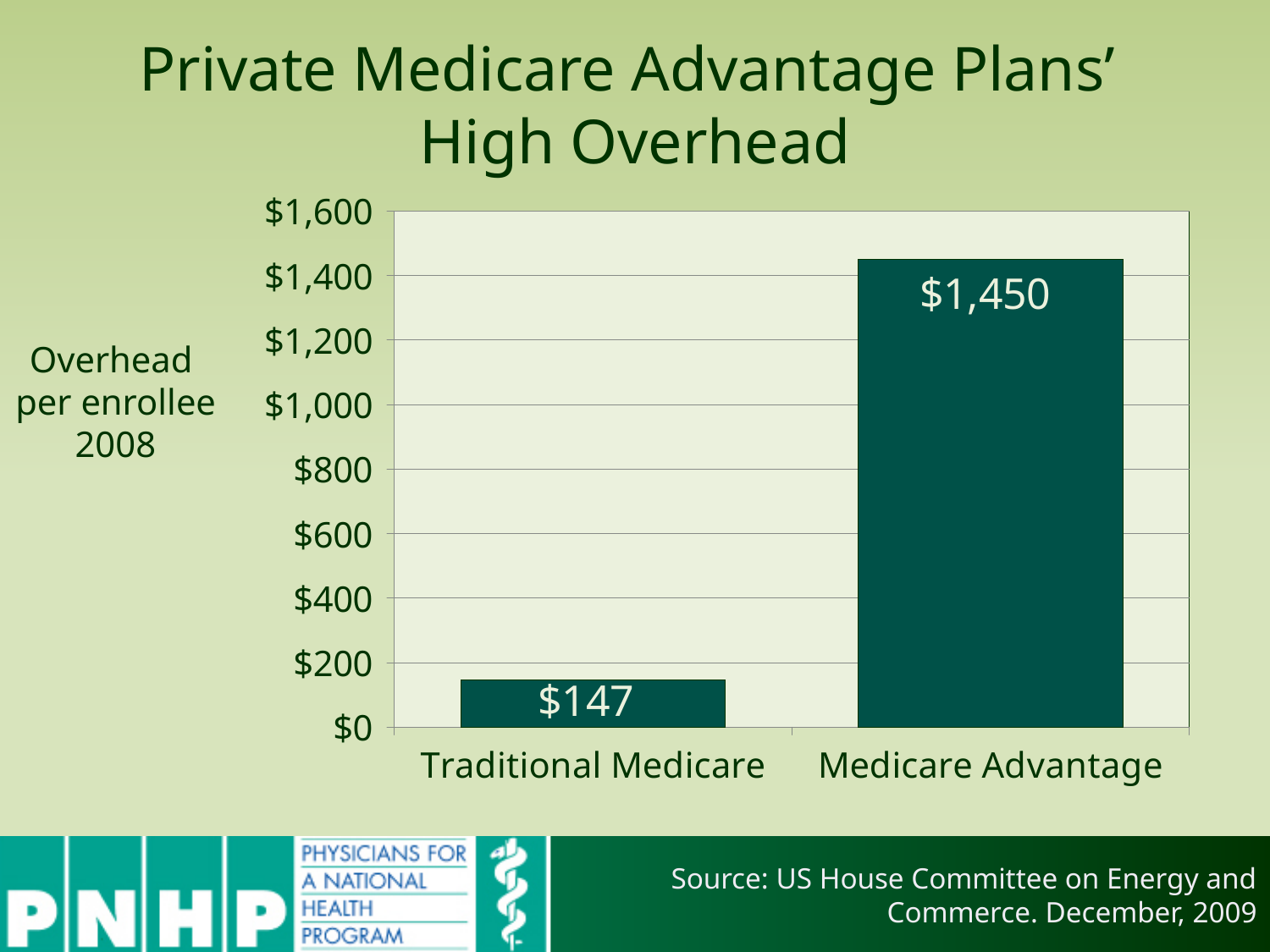
What is the difference in overhead per enrollee between Medicare Advantage and Traditional Medicare? $1,303 Which category has the highest overhead per enrollee? Medicare Advantage Is the value for Traditional Medicare greater or less than $200? less What is the overhead per enrollee for Medicare Advantage? $1,450 What kind of chart is shown on the slide? Bar chart What is the title of the slide? Private Medicare Advantage Plans' High Overhead How many categories are shown in the chart? 2 Which category has the lowest overhead per enrollee? Traditional Medicare Which has a larger overhead per enrollee, Traditional Medicare or Medicare Advantage? Medicare Advantage What year does the overhead per enrollee data refer to? 2008 What is the overhead per enrollee for Traditional Medicare? $147 Is the value for Medicare Advantage greater or less than $1,400? greater